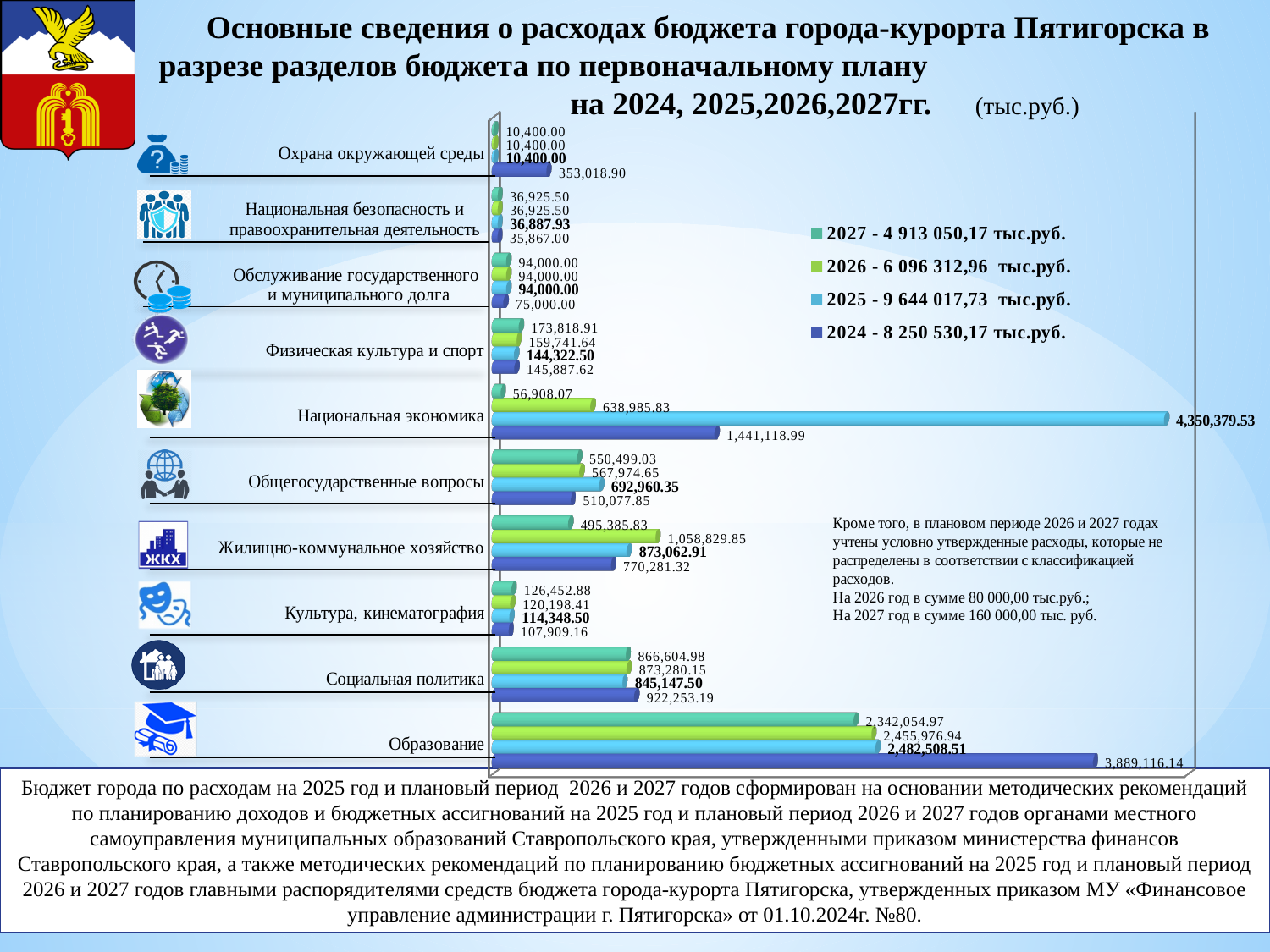
Which budget section has the lowest value in 2027? Охрана окружающей среды What is the value for Национальная экономика in 2025? 4,350,379.53 What type of chart is shown on the slide? bar chart Which is larger for Культура, кинематография: the 2027 value or the 2024 value? 2027 What is the value for Социальная политика in 2027? 866,604.98 What is the difference between the 2024 and 2025 values for Образование? 1,406,607.63 Which budget section has the highest value in 2024? Образование What is the value for Жилищно-коммунальное хозяйство in 2026? 1,058,829.85 How many series does the chart legend list? 4 According to the legend, what is the total budget expenditure for 2025? 9 644 017,73 тыс.руб. How many budget sections (categories) are shown on the chart? 10 What is the value for Образование in 2024? 3,889,116.14